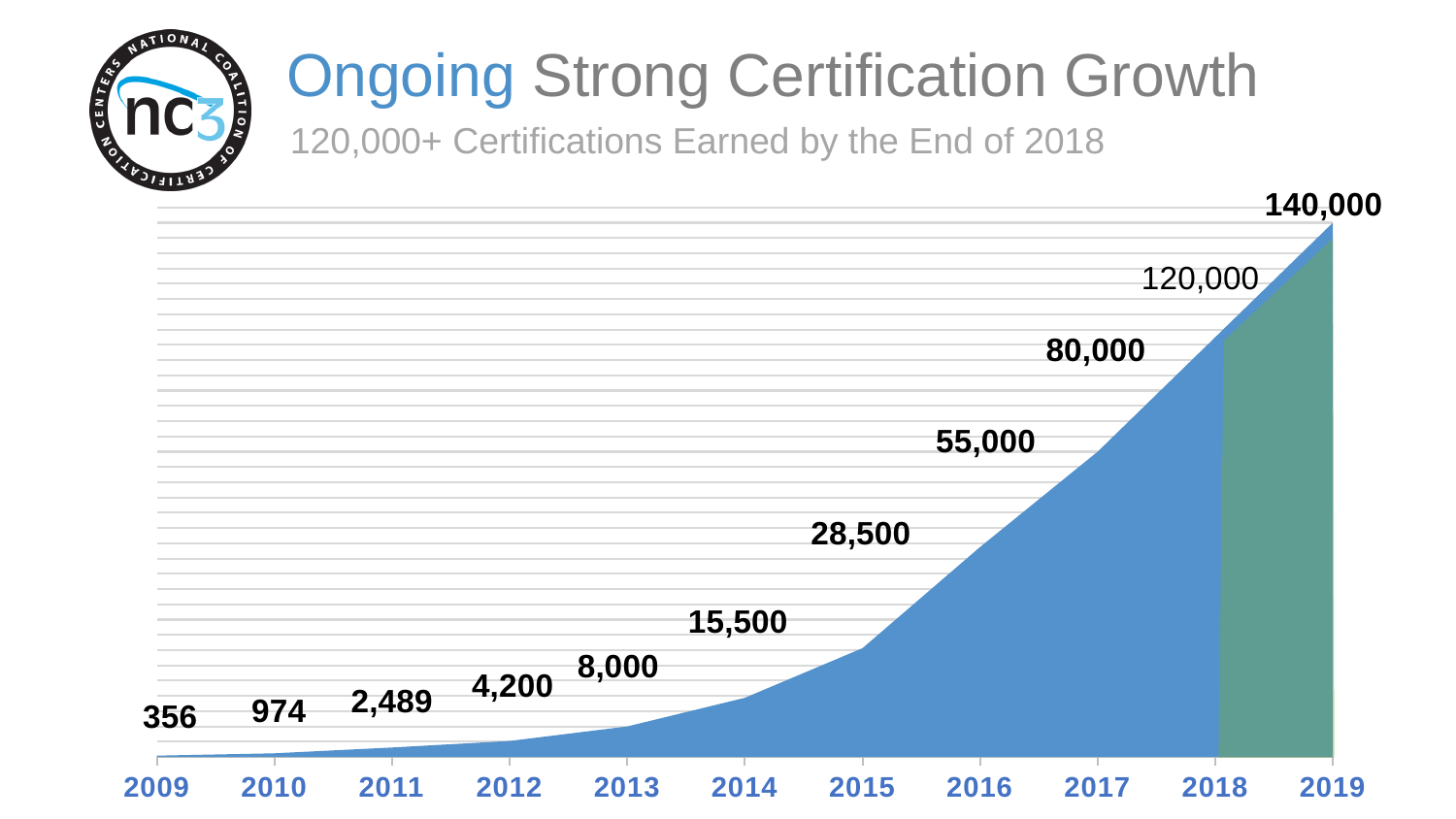
Which year has the lowest value on the chart? 2009 What kind of chart is shown on the slide? Area chart What is the difference between the values for 2018 and 2017? 40,000 What value is shown for 2018? 120,000 What value is shown for 2015? 28,500 How many years are plotted along the x axis? 11 What is the difference between the values for 2014 and 2013? 7,500 What value is shown for 2011? 2,489 Which year has the highest value on the chart? 2019 Which is larger, the value for 2016 or the value for 2015? 2016 Do the values rise or fall from 2009 to 2019? Rise What is the title of the chart on the slide? Ongoing Strong Certification Growth